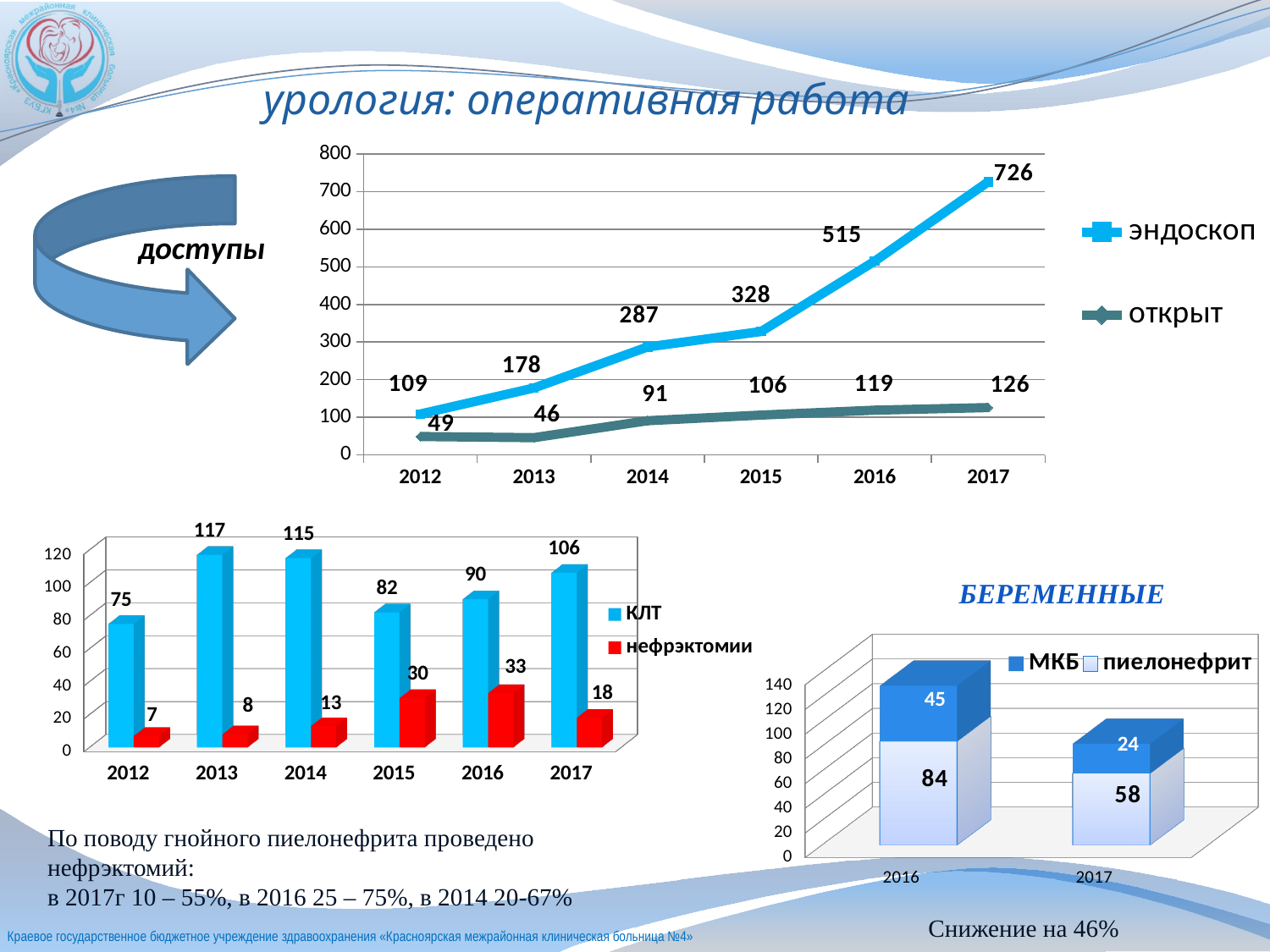
In the БЕРЕМЕННЫЕ chart, what is the value for пиелонефрит in 2017? 58 In the top line chart, what is the value for открыт in 2013? 46 In the bottom-left bar chart, what is the difference between КЛТ and нефрэктомии in 2017? 88 In the БЕРЕМЕННЫЕ chart, what is the total of the stacked bar for 2016? 129 In the bottom-left bar chart, what is the value for КЛТ in 2013? 117 In the bottom-left chart, how many years are shown on the x axis? 6 In the bottom-left bar chart, which year has the lowest value for КЛТ? 2012 In the top line chart, how many series does the legend list? 2 In the bottom-left bar chart, which year has the highest value for нефрэктомии? 2016 In the top line chart, does the эндоскоп series rise or fall from 2012 to 2017? rise In the top line chart, what is the difference between эндоскоп and открыт in 2016? 396 In the top line chart, what is the value for эндоскоп in 2017? 726